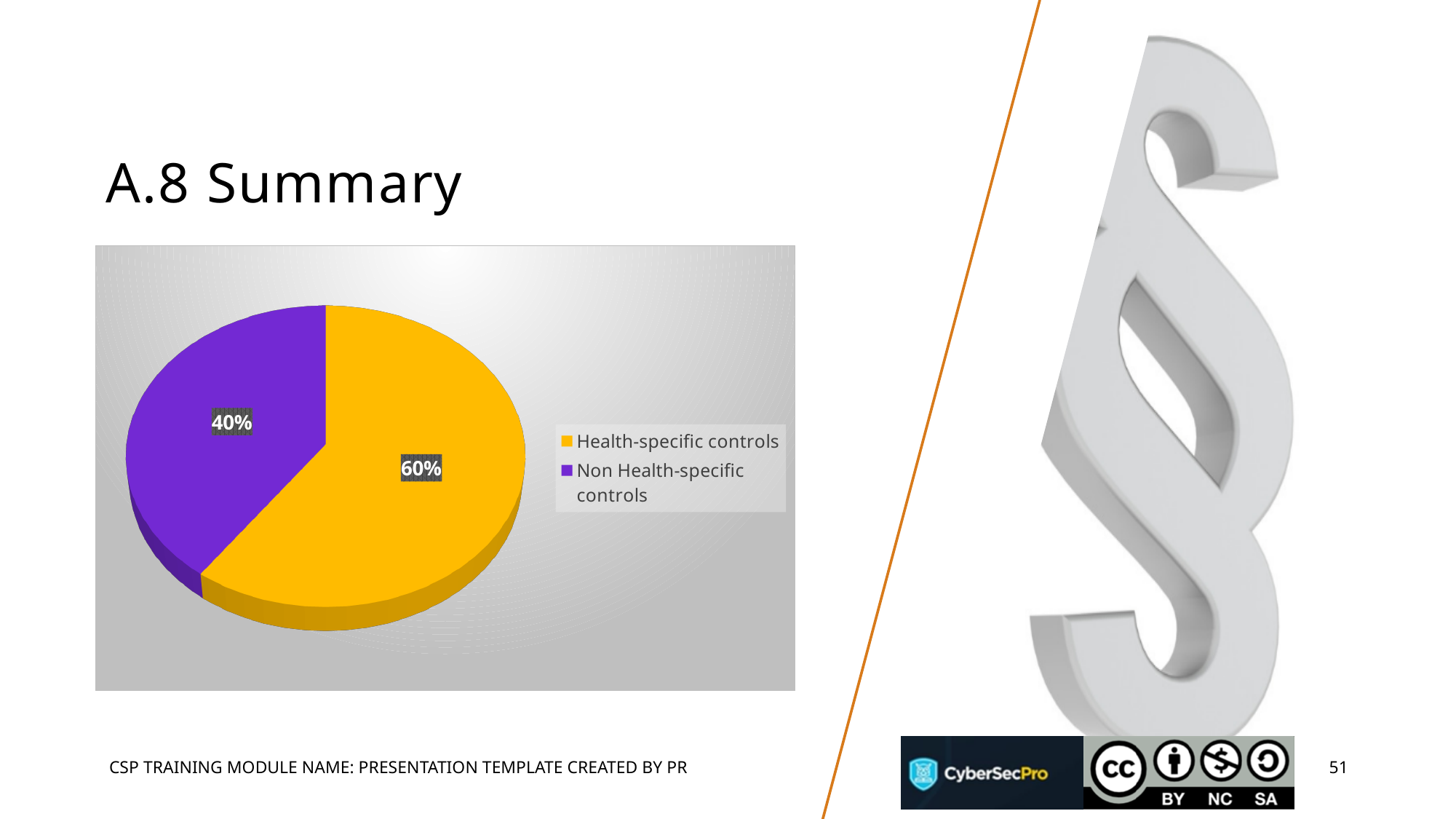
Which category has the largest slice of the pie? Health-specific controls Which category has the smallest slice of the pie? Non Health-specific controls What kind of chart is shown on the slide? pie chart How many slices does the pie chart have? 2 What colour is the slice for Health-specific controls? yellow Which is larger, the slice for Health-specific controls or the slice for Non Health-specific controls? Health-specific controls What colour is the slice for Non Health-specific controls? purple What is the difference in percentage points between Health-specific controls and Non Health-specific controls? 20% How many entries does the legend list? 2 What share of the pie is Non Health-specific controls? 40% What share of the pie is Health-specific controls? 60%